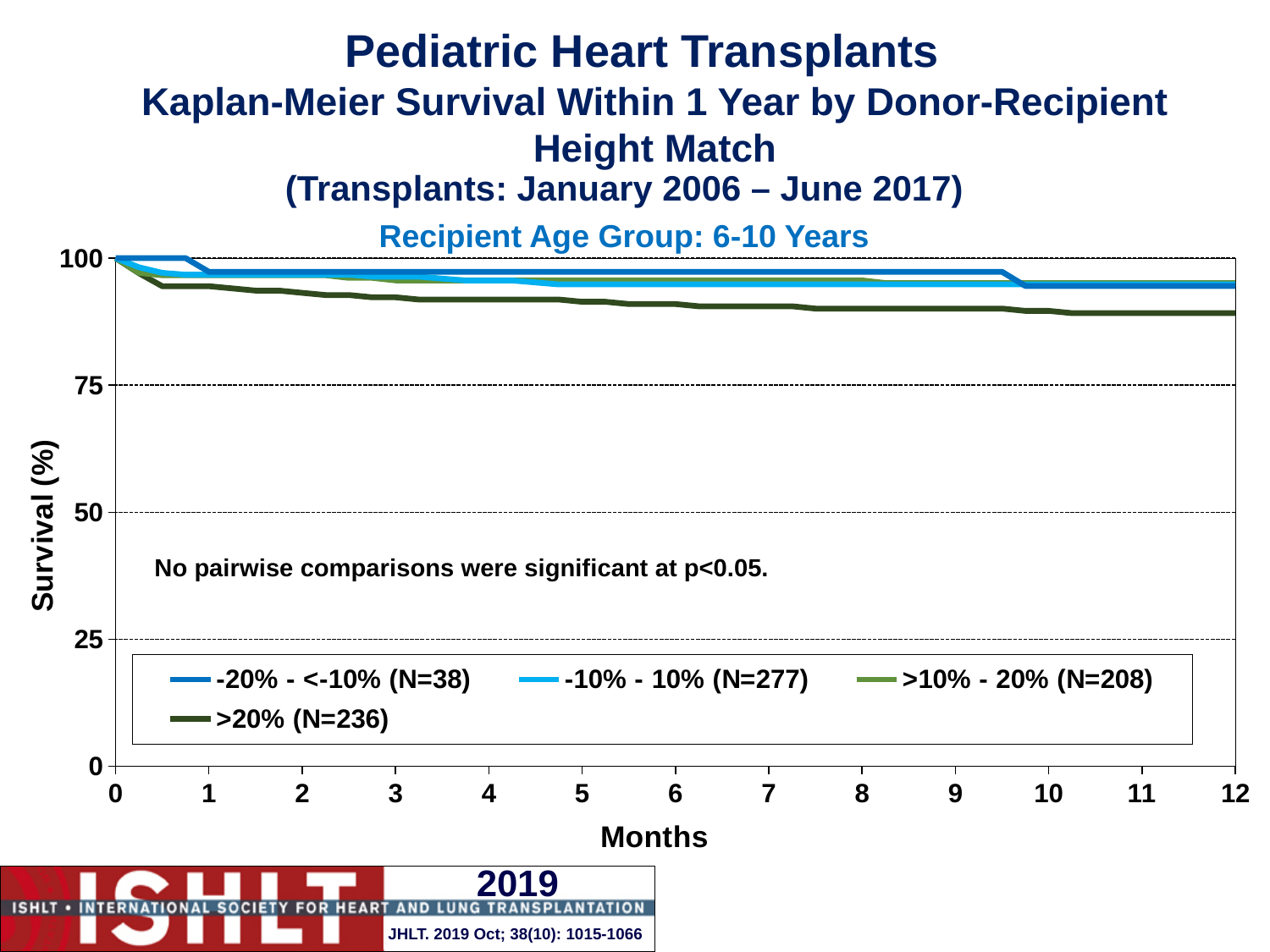
What is the N for the -10% - 10% group shown in the legend? 277 What is the label of the y axis? Survival (%) How many tick marks are labelled on the Months axis? 13 What kind of chart is shown on the slide? Line chart At 12 months, which has higher survival: the >20% group or the -10% - 10% group? -10% - 10% group How many series does the legend list? 4 Do the survival curves rise or fall as months increase? Fall At 12 months, is survival for the >20% group greater or less than 75? greater At 12 months, is survival for the -10% - 10% group greater or less than 75? greater Which recipient age group does the chart cover? 6-10 Years At 6 months, is survival for the >20% group greater or less than 100? less Which height-match group has the lowest survival at 12 months? >20% (N=236)